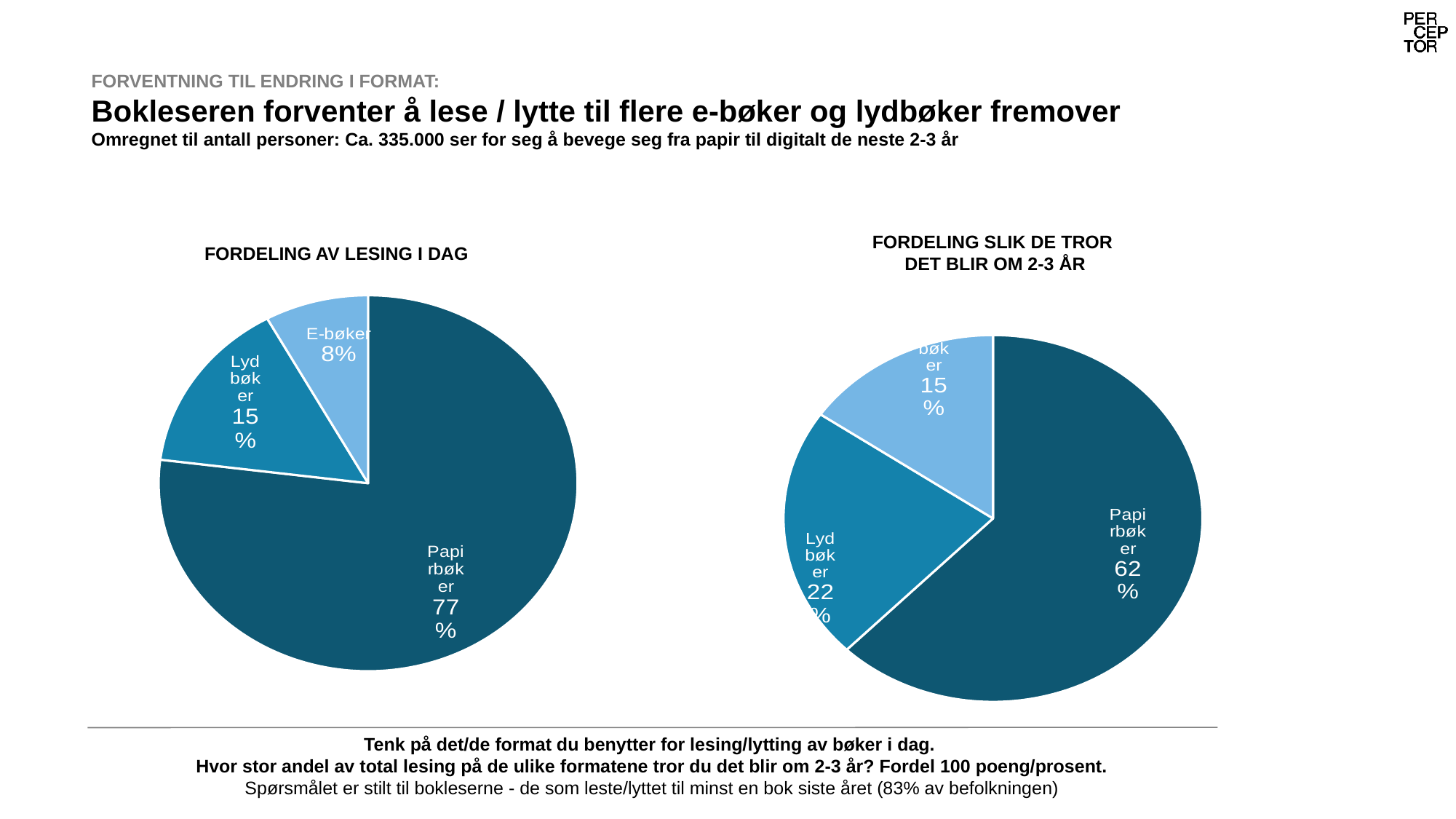
In the 'FORDELING SLIK DE TROR DET BLIR OM 2-3 ÅR' chart, what share is shown on the light blue slice? 15% In the 'FORDELING AV LESING I DAG' chart, what share is Lydbøker? 15% In the 'FORDELING SLIK DE TROR DET BLIR OM 2-3 ÅR' chart, what share is Lydbøker? 22% What kind of chart is used for 'FORDELING AV LESING I DAG'? Pie chart In the 'FORDELING AV LESING I DAG' chart, what share is Papirbøker? 77% In the 'FORDELING SLIK DE TROR DET BLIR OM 2-3 ÅR' chart, what share is Papirbøker? 62% Is the Lydbøker share larger in 'FORDELING AV LESING I DAG' or in 'FORDELING SLIK DE TROR DET BLIR OM 2-3 ÅR'? FORDELING SLIK DE TROR DET BLIR OM 2-3 ÅR In the 'FORDELING AV LESING I DAG' chart, how many slices does the pie have? 3 In the 'FORDELING AV LESING I DAG' chart, what share is E-bøker? 8% In the 'FORDELING AV LESING I DAG' chart, which category has the smallest slice? E-bøker In the 'FORDELING SLIK DE TROR DET BLIR OM 2-3 ÅR' chart, which category has the largest slice? Papirbøker What is the difference between the Papirbøker share in 'FORDELING AV LESING I DAG' and in 'FORDELING SLIK DE TROR DET BLIR OM 2-3 ÅR'? 15 percentage points